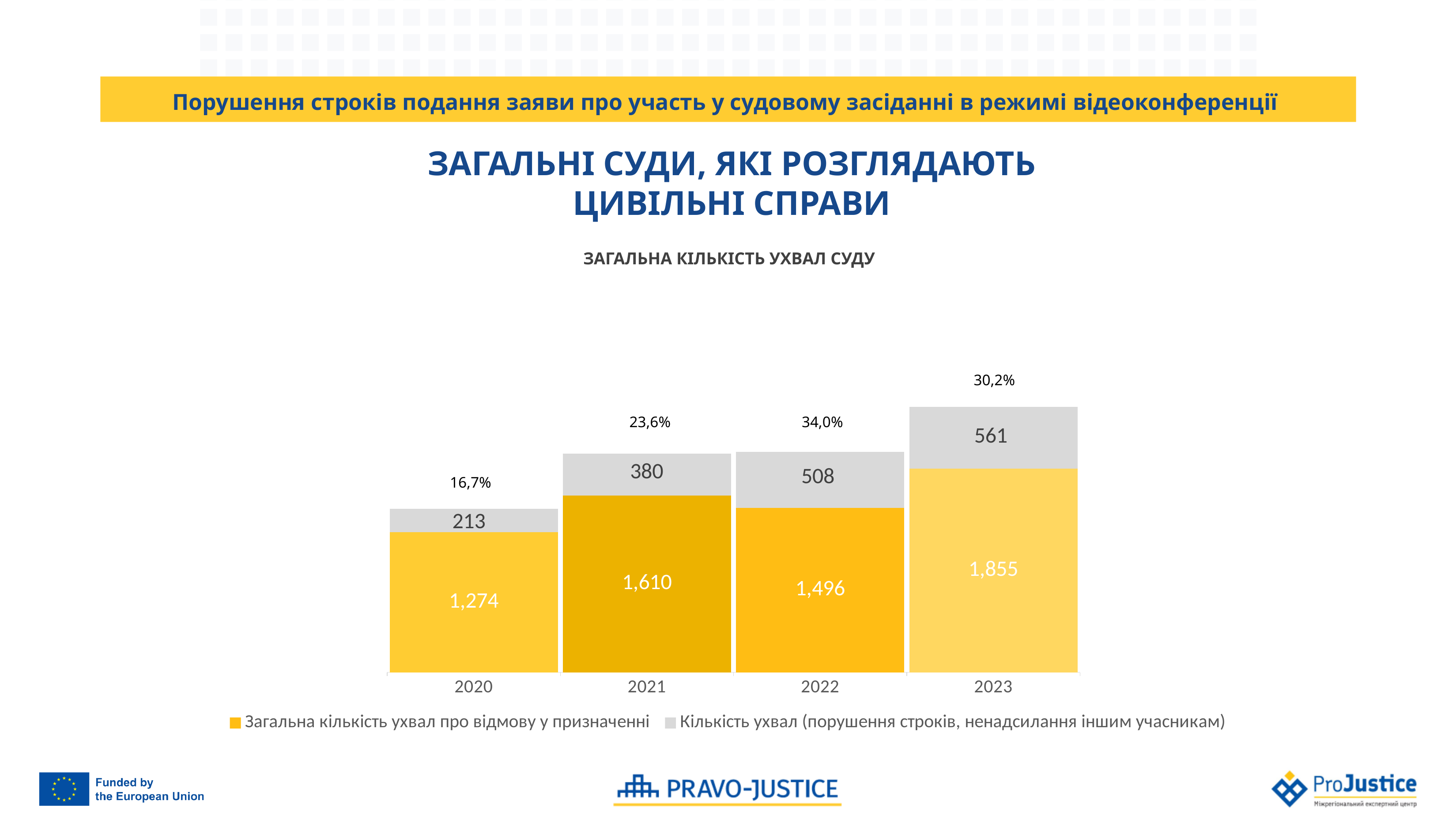
Which year has the lowest value for "Загальна кількість ухвал про відмову у призначенні"? 2020 What is the difference between the "Загальна кількість ухвал про відмову у призначенні" values for 2023 and 2020? 581 What kind of chart is shown on the slide? Stacked bar chart What is the value of "Кількість ухвал (порушення строків, ненадсилання іншим учасникам)" for 2022? 508 What is the title of the chart? ЗАГАЛЬНА КІЛЬКІСТЬ УХВАЛ СУДУ Which is larger: the "Загальна кількість ухвал про відмову у призначенні" value for 2021 or for 2022? 2021 How many series does the chart legend list? 2 How many years are shown on the x axis of the chart? 4 What is the total of the stacked bar for 2023? 2,416 Which year has the highest value for "Кількість ухвал (порушення строків, ненадсилання іншим учасникам)"? 2023 What percentage is shown above the bar for 2023? 30,2% What is the value of "Загальна кількість ухвал про відмову у призначенні" for 2021? 1,610